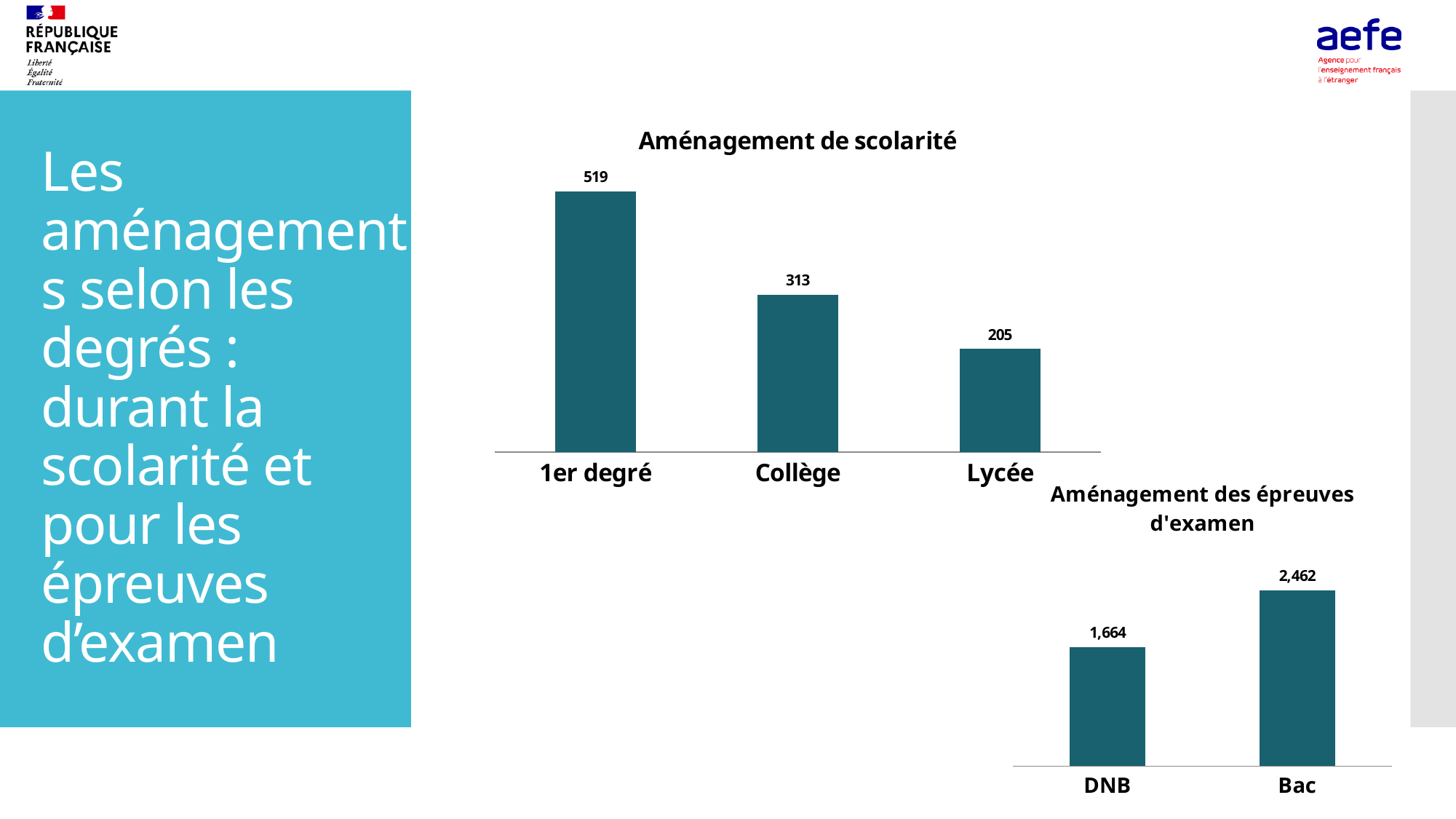
What kind of chart is the 'Aménagement des épreuves d'examen' chart? bar chart In the 'Aménagement de scolarité' chart, how many categories are shown? 3 In the 'Aménagement de scolarité' chart, do the values rise or fall from 1er degré to Lycée? fall In the 'Aménagement de scolarité' chart, what is the value for 1er degré? 519 In the 'Aménagement des épreuves d'examen' chart, what is the value for DNB? 1,664 In the 'Aménagement de scolarité' chart, which category has the highest value? 1er degré In the 'Aménagement de scolarité' chart, which category has the lowest value? Lycée In the 'Aménagement des épreuves d'examen' chart, what is the value for Bac? 2,462 In the 'Aménagement des épreuves d'examen' chart, which is larger, DNB or Bac? Bac In the 'Aménagement de scolarité' chart, what is the value for Collège? 313 In the 'Aménagement de scolarité' chart, what is the value for Lycée? 205 In the 'Aménagement de scolarité' chart, what is the difference between the values for 1er degré and Collège? 206